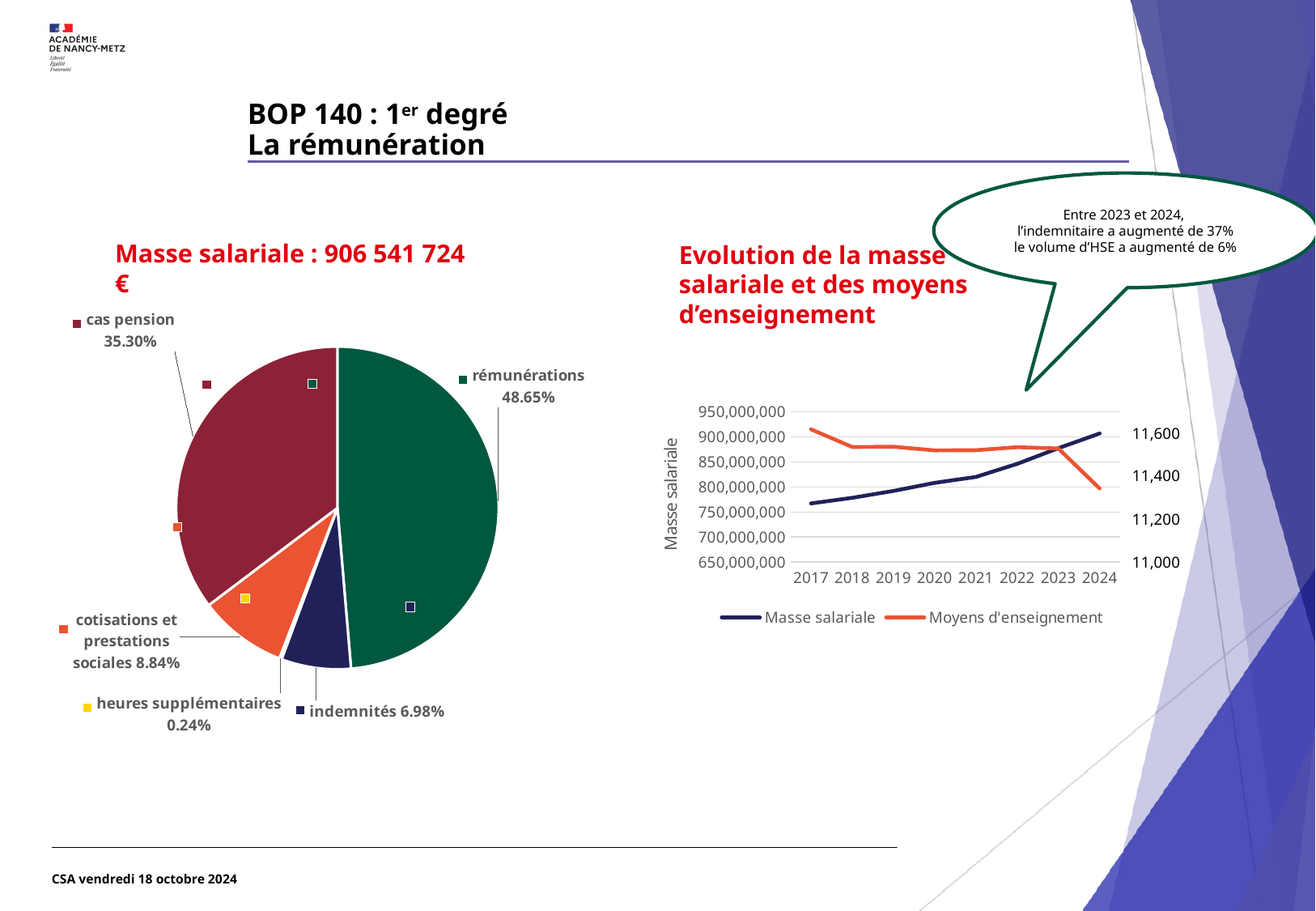
In the chart 'Evolution de la masse salariale et des moyens d'enseignement', does the 'Masse salariale' series rise or fall from 2017 to 2024? rise How many slices does the pie chart 'Masse salariale : 906 541 724 €' have? 5 In the pie chart 'Masse salariale : 906 541 724 €', which category has the smallest share? heures supplémentaires In the chart 'Evolution de la masse salariale et des moyens d'enseignement', is the 'Masse salariale' value for 2017 greater or less than 800,000,000? less In the pie chart 'Masse salariale : 906 541 724 €', which category has the largest share? rémunérations How many series does the legend of the chart 'Evolution de la masse salariale et des moyens d'enseignement' list? 2 In the pie chart 'Masse salariale : 906 541 724 €', what is the difference in percentage points between 'rémunérations' and 'cas pension'? 13.35 In the pie chart 'Masse salariale : 906 541 724 €', what share does 'heures supplémentaires' represent? 0.24% In the pie chart 'Masse salariale : 906 541 724 €', what share does 'cas pension' represent? 35.30% In the pie chart 'Masse salariale : 906 541 724 €', what share does 'rémunérations' represent? 48.65% In the pie chart 'Masse salariale : 906 541 724 €', which is larger: 'cotisations et prestations sociales' or 'indemnités'? cotisations et prestations sociales What kind of chart is the chart titled 'Evolution de la masse salariale et des moyens d'enseignement'? line chart